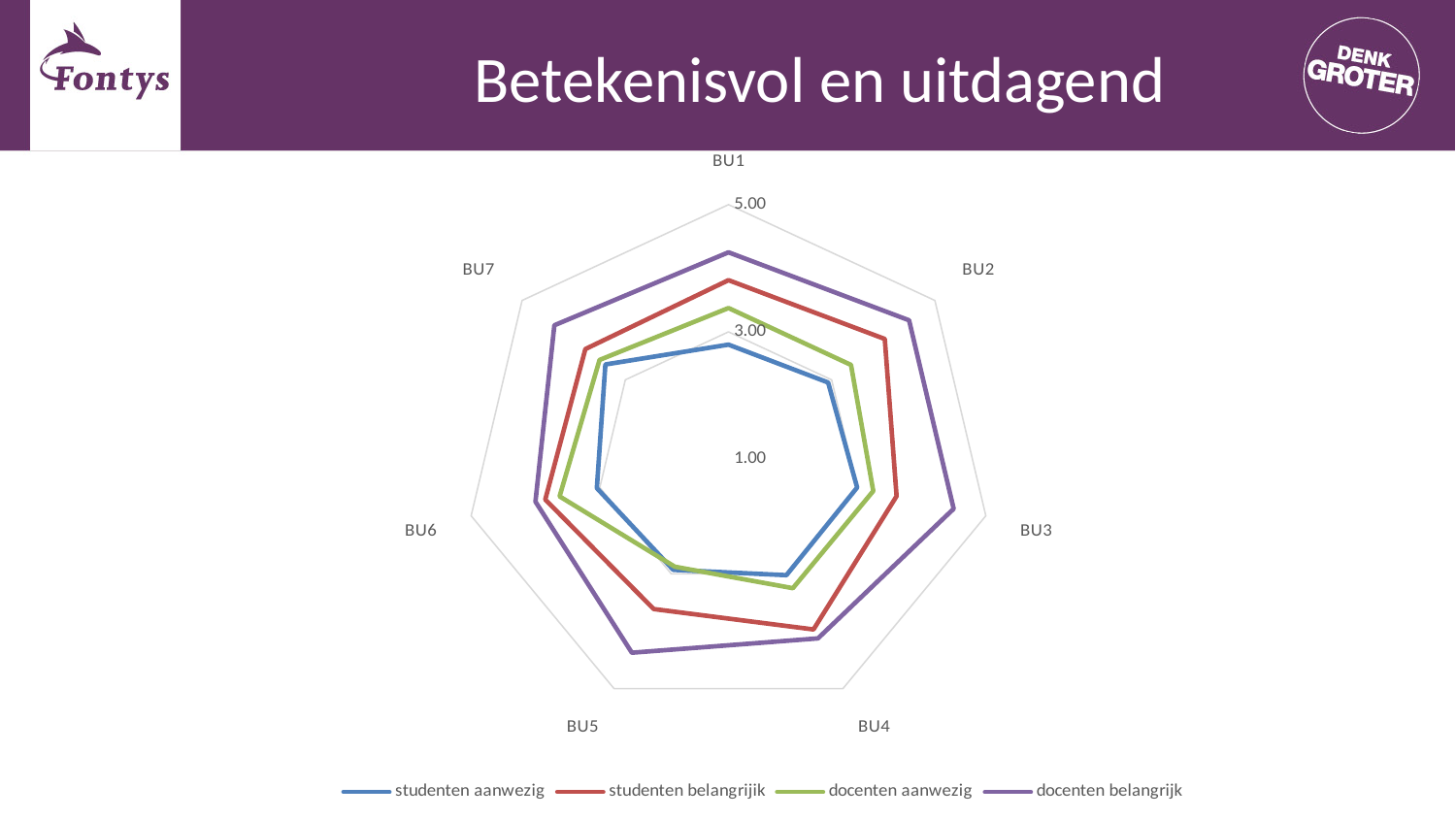
Which series has the lowest value at BU1? studenten aanwezig How many categories (axes) does the radar chart have? 7 Which series has the highest value at BU1? docenten belangrijk Is the value of studenten belangrijk at BU4 greater or less than 3.00? greater At BU3, which is larger: docenten belangrijk or studenten aanwezig? docenten belangrijk Is the value of docenten belangrijk at BU1 greater or less than 3.00? greater What is the title of the slide containing the chart? Betekenisvol en uitdagend At BU2, which is larger: studenten belangrijk or docenten aanwezig? studenten belangrijk How many series does the legend list? 4 Is the value of docenten belangrijk at BU4 greater or less than 5.00? less What kind of chart is shown on the slide? radar chart Which series is drawn in purple according to the legend? docenten belangrijk